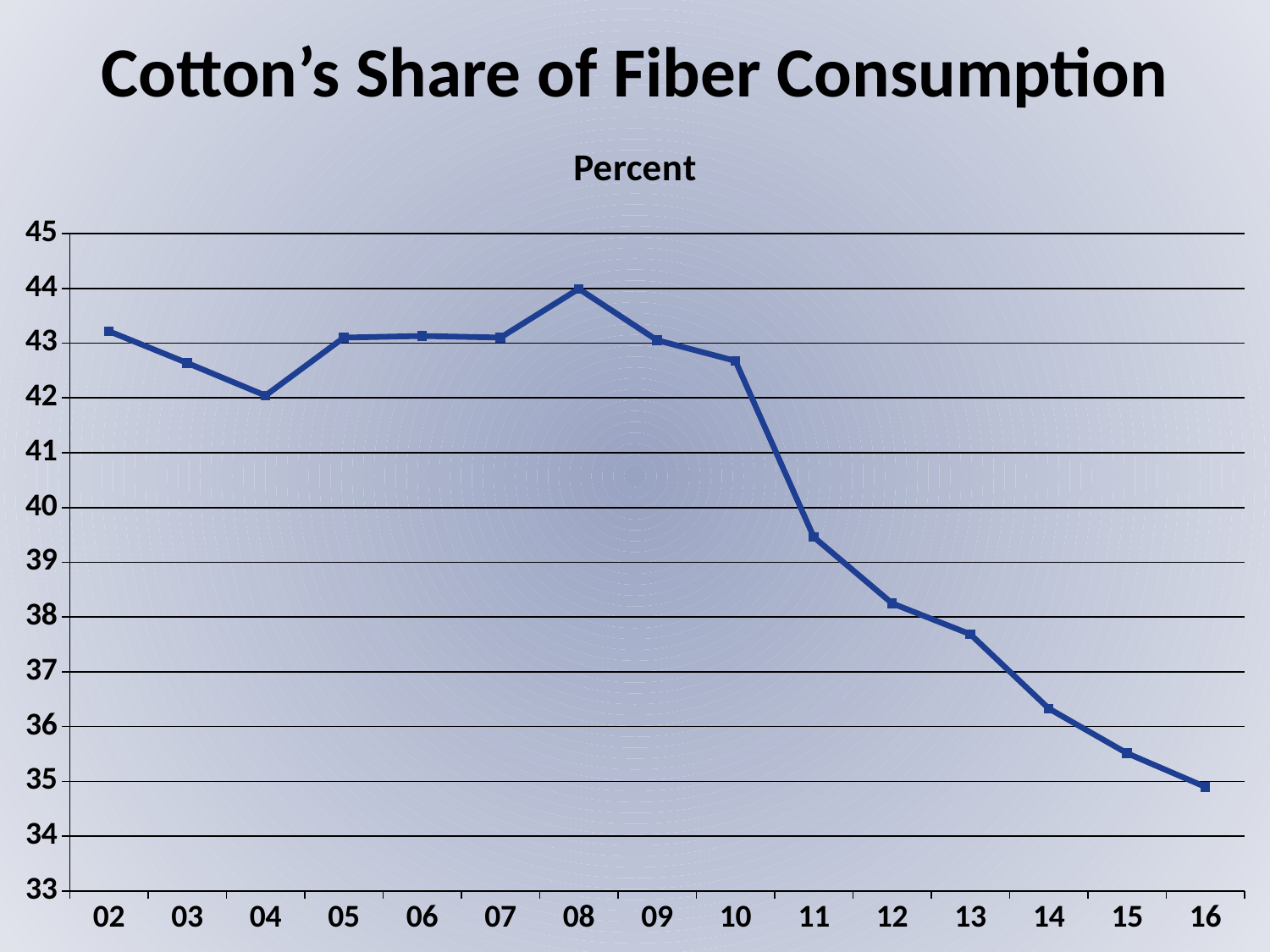
How many years are plotted on the x axis? 15 What unit label is shown above the chart's plot area? Percent What is the title of the chart? Cotton's Share of Fiber Consumption Is the value for 04 greater or less than 41? greater Which year has the larger value, 04 or 05? 05 In which year is cotton's share of fiber consumption highest? 08 What kind of chart is shown on the slide? line chart Which year has the larger value, 08 or 11? 08 Is the value for 16 greater or less than 36? less In which year is cotton's share of fiber consumption lowest? 16 Overall, does cotton's share of fiber consumption rise or fall from 02 to 16? fall Is the value for 11 greater or less than 40? less